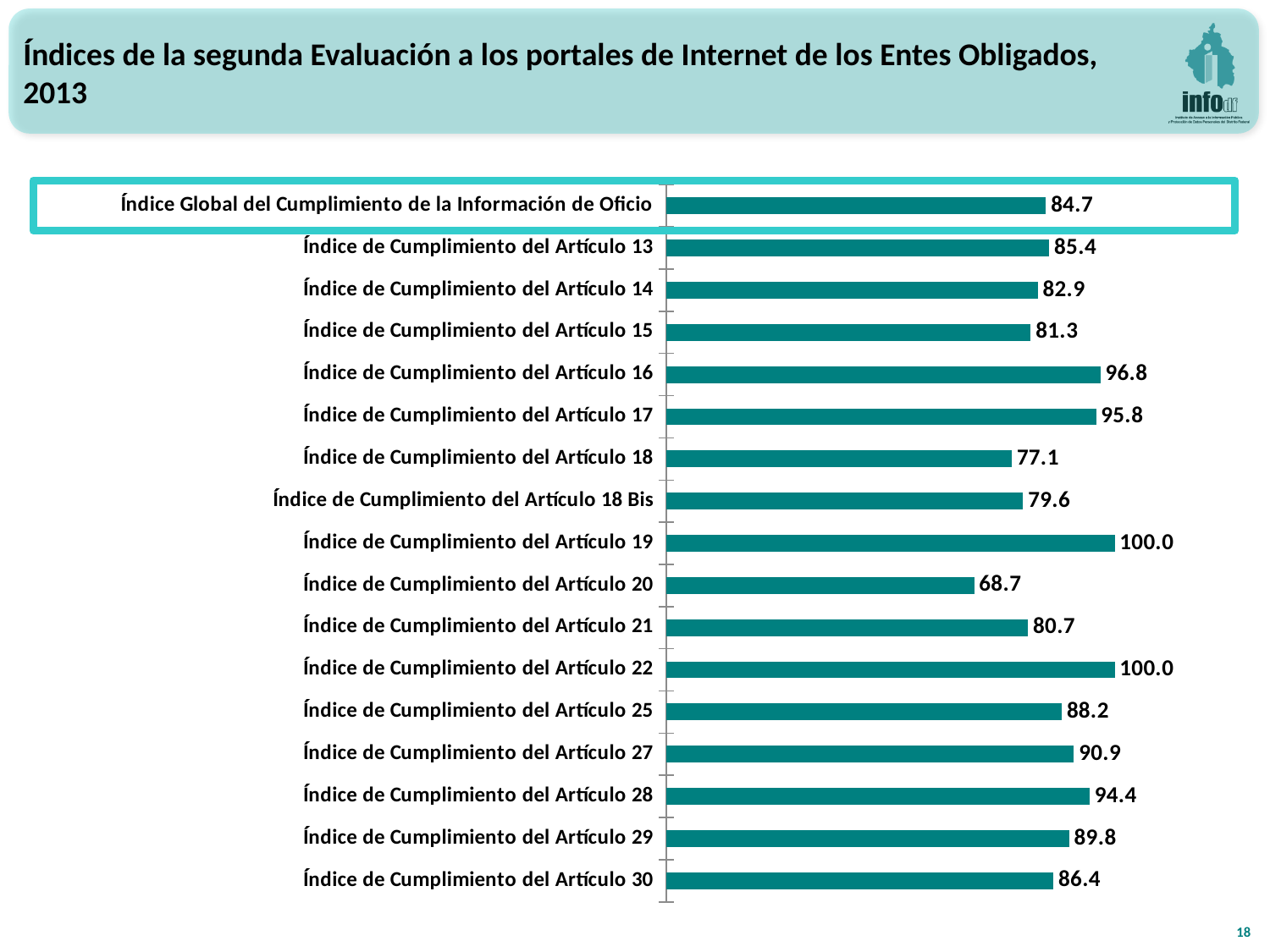
How many categories are plotted in the chart? 17 What is the difference between the values for Artículo 17 and Artículo 18? 18.7 What is the value for Índice Global del Cumplimiento de la Información de Oficio? 84.7 What kind of chart is shown on the slide? Bar chart Which is larger, the value for Artículo 28 or the value for Artículo 27? Artículo 28 What is the value for Índice de Cumplimiento del Artículo 16? 96.8 Which two categories share the highest value of 100.0? Índice de Cumplimiento del Artículo 19 and Índice de Cumplimiento del Artículo 22 Which category is highlighted with a box around its label and bar? Índice Global del Cumplimiento de la Información de Oficio What is the difference between the values for Artículo 25 and Artículo 21? 7.5 What is the value for Índice de Cumplimiento del Artículo 18 Bis? 79.6 Which is larger, the value for Artículo 14 or the value for Artículo 30? Artículo 30 Which category has the lowest value? Índice de Cumplimiento del Artículo 20